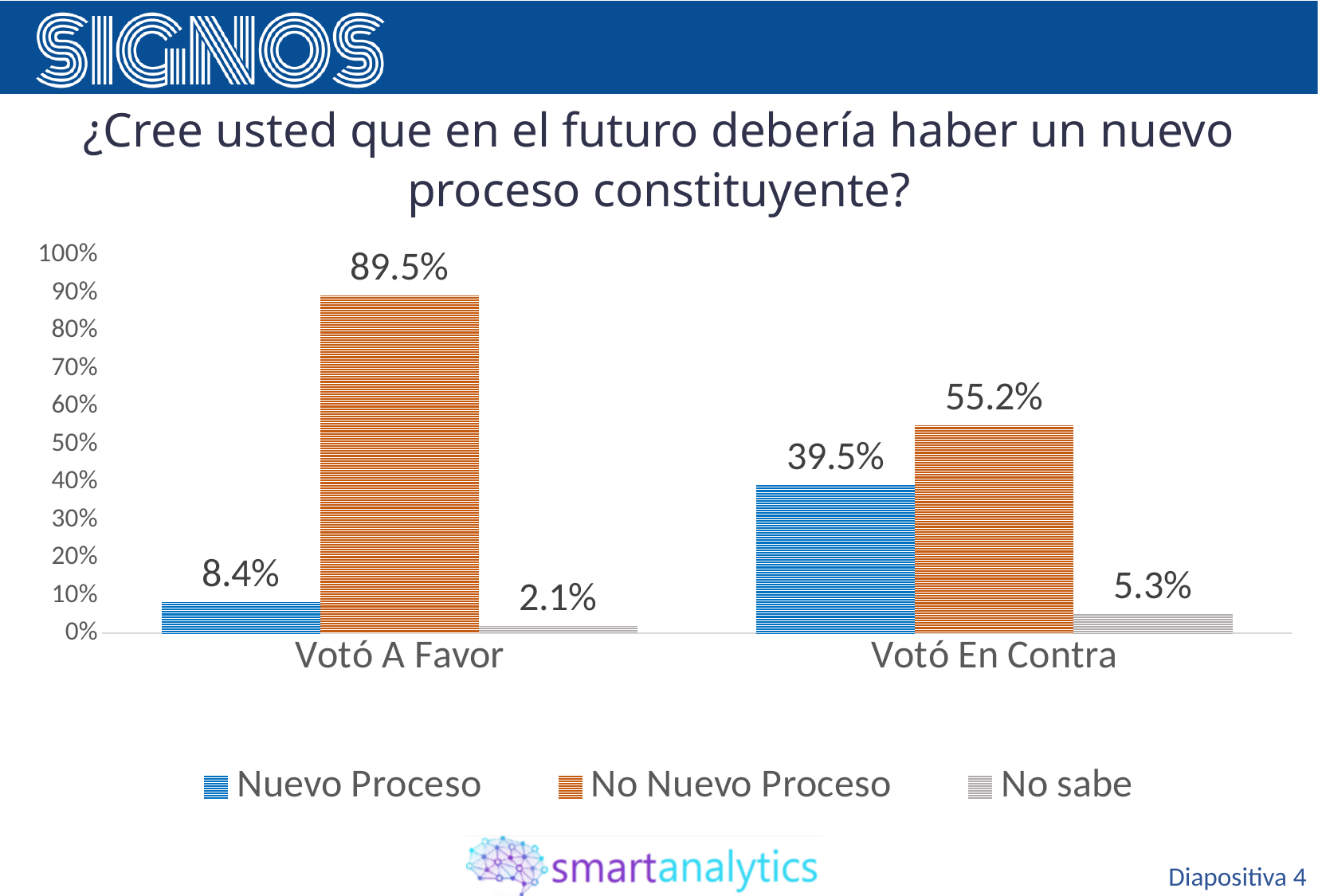
What is the value for No Nuevo Proceso among those who Votó En Contra? 55.2% What is the difference between No Nuevo Proceso and Nuevo Proceso in the Votó A Favor group? 81.1% What is the value for No sabe among those who Votó A Favor? 2.1% Which series has the lowest value in the Votó En Contra group? No sabe What colour represents the No Nuevo Proceso series? orange How many series does the legend list? 3 Which is larger: Nuevo Proceso for Votó En Contra or Nuevo Proceso for Votó A Favor? Nuevo Proceso for Votó En Contra Is the value for No Nuevo Proceso in the Votó En Contra group greater or less than 50%? greater Which series has the highest value in the Votó A Favor group? No Nuevo Proceso What is the value for Nuevo Proceso among those who Votó A Favor? 8.4% How many categories are shown on the x axis? 2 What kind of chart is shown on the slide? bar chart